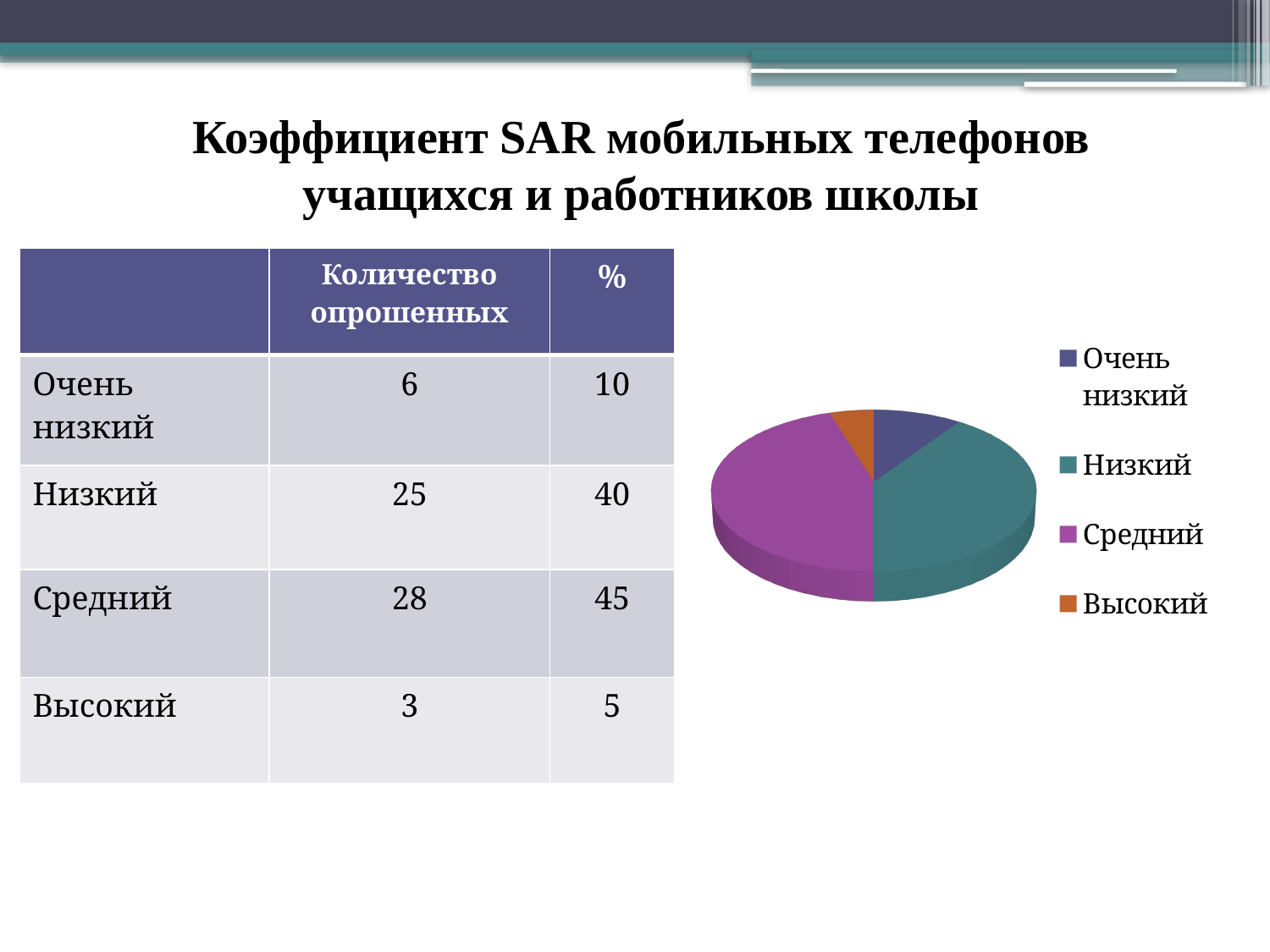
What kind of chart is shown on the slide? pie chart According to the table, how many respondents are in the Низкий category? 25 How many slices does the pie chart have? 4 Which category has the largest slice in the pie chart? Средний Which slice is larger in the pie chart, Очень низкий or Средний? Средний How many entries does the pie chart's legend list? 4 Which category has the smallest slice in the pie chart? Высокий What colour is the Средний slice in the pie chart? purple According to the table, how many more respondents are in the Средний category than in the Высокий category? 25 According to the table, what share of respondents does the Средний slice represent? 45 According to the table, what share of respondents does the Очень низкий slice represent? 10 Which slice is larger in the pie chart, Низкий or Высокий? Низкий